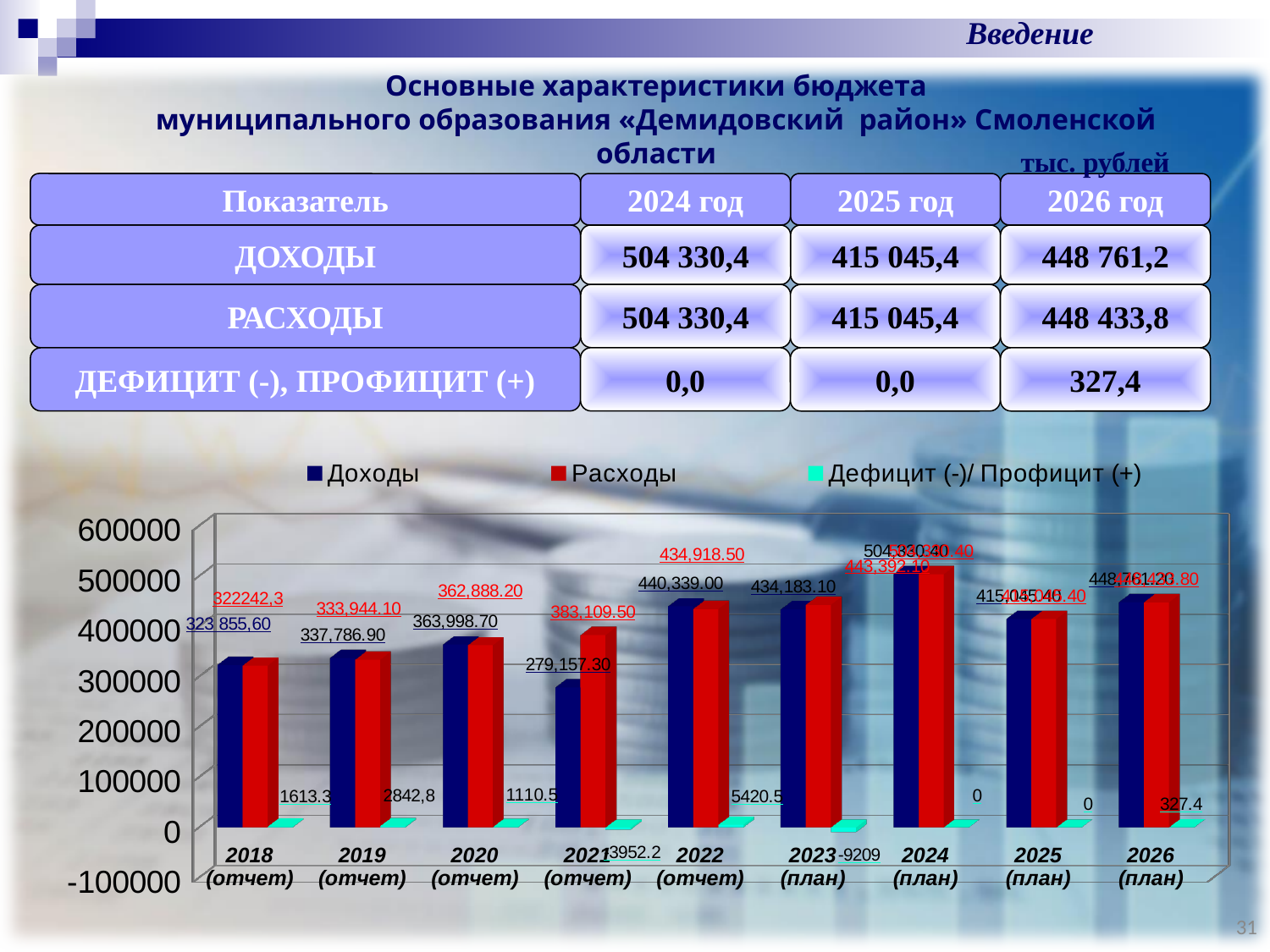
What is the value of Расходы for 2021 (отчет) in the chart? 383,109.50 What is the value of Дефицит (-)/ Профицит (+) for 2022 (отчет) in the chart? 5420.5 In which year is Доходы highest in the chart? 2024 (план) What colour represents Расходы in the chart legend? red How many series does the chart legend list? 3 In which year is Доходы lowest in the chart? 2021 (отчет) What is the value of Доходы for 2020 (отчет) in the chart? 363,998.70 For 2021 (отчет), which is larger in the chart: Доходы or Расходы? Расходы What kind of chart is shown on the slide? bar chart What is the value of Доходы for 2022 (отчет) in the chart? 440,339.00 How many year categories are shown along the x axis of the chart? 9 Is the value of Доходы for 2018 (отчет) greater or less than 400000? less